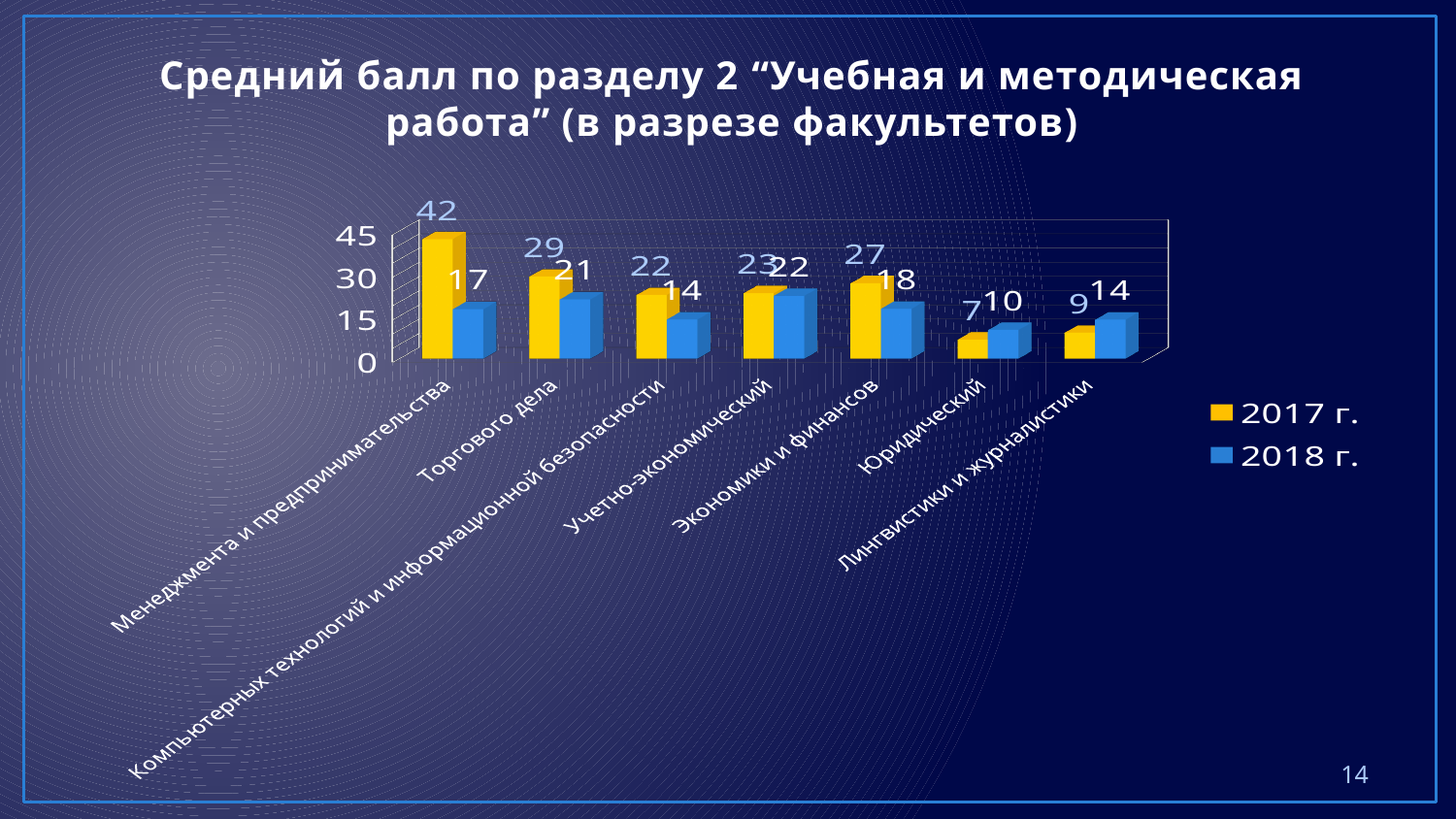
Which faculty has the lowest 2017 г. value? Юридический Which faculty has the highest 2017 г. value? Менеджмента и предпринимательства What kind of chart is shown on the slide? Bar chart What is the 2017 г. value for Менеджмента и предпринимательства? 42 How many series does the legend list? 2 What is the 2018 г. value for Торгового дела? 21 How many faculties are shown on the x axis? 7 What is the difference between the 2017 г. and 2018 г. values for Менеджмента и предпринимательства? 25 What is the 2017 г. value for Экономики и финансов? 27 Is the 2017 г. value for Торгового дела greater or less than 15? greater Which is larger for Лингвистики и журналистики, the 2017 г. value or the 2018 г. value? 2018 г. What is the 2018 г. value for Юридический? 10